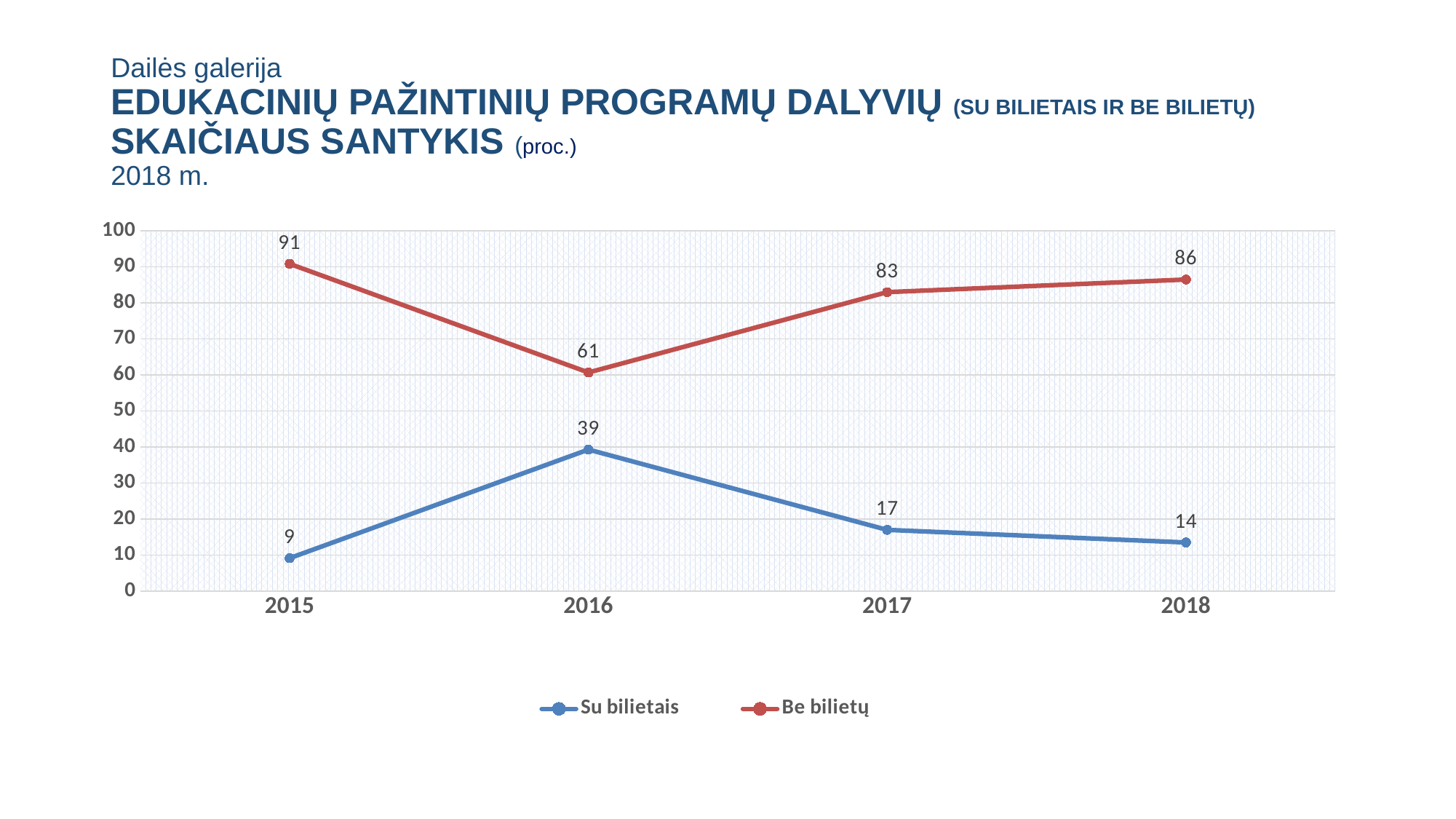
What is the value for Su bilietais in 2016? 39 What is the value for Be bilietų in 2015? 91 In which year is the Be bilietų value lowest? 2016 Does the Su bilietais value rise or fall from 2016 to 2018? fall How many series does the legend list? 2 In which year is the Su bilietais value highest? 2016 Which is larger in 2018: Su bilietais or Be bilietų? Be bilietų What kind of chart is shown on the slide? line chart How many years are shown on the x axis? 4 Is the value for Su bilietais in 2015 greater or less than 10? less What is the value for Be bilietų in 2018? 86 What is the difference between Be bilietų and Su bilietais in 2017? 66